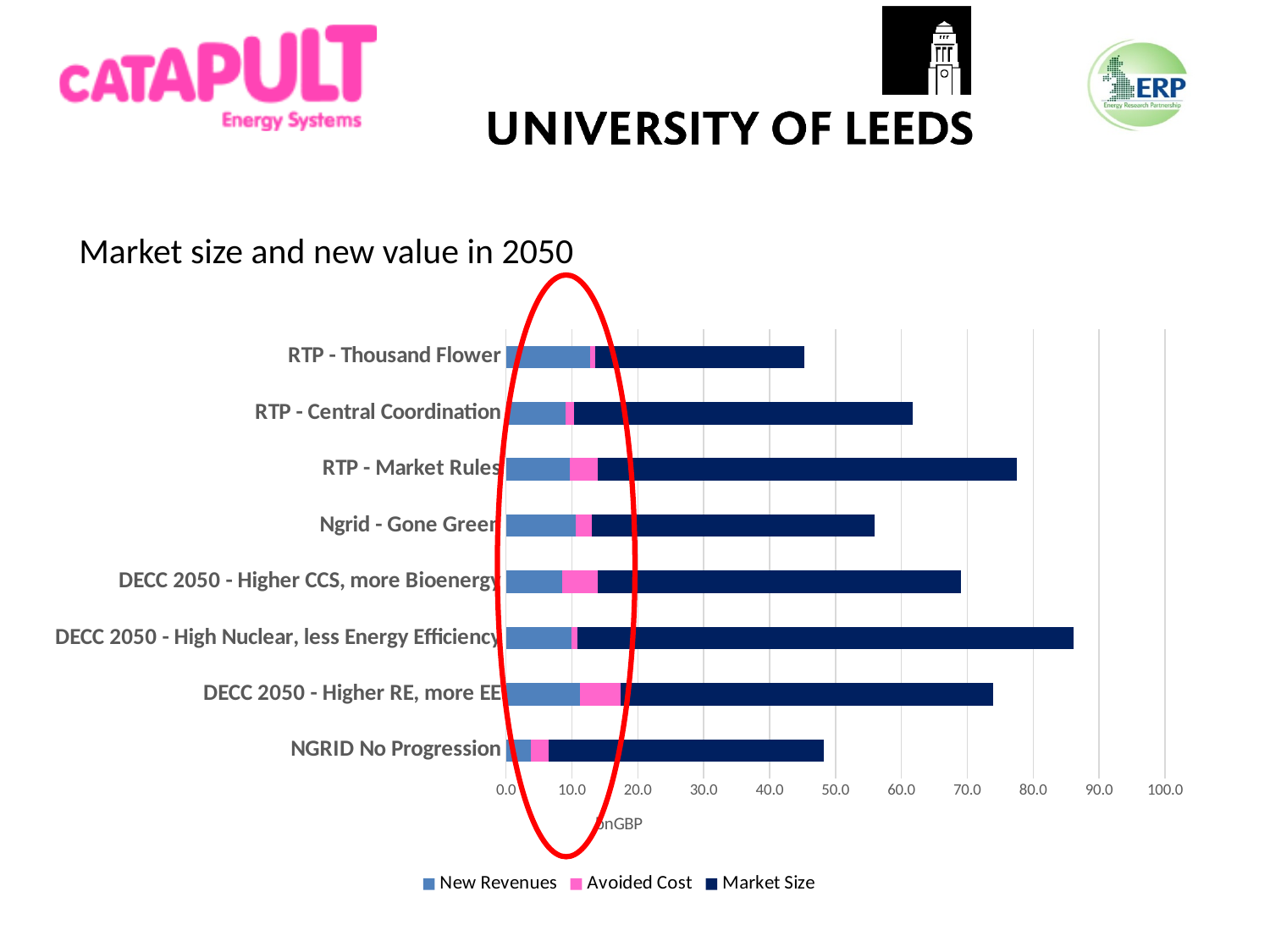
How many series does the chart legend list? 3 Is the total bar for DECC 2050 - High Nuclear, less Energy Efficiency greater or less than 80.0? greater Which scenario has the longest total bar in the chart? DECC 2050 - High Nuclear, less Energy Efficiency What kind of chart is shown on the slide? bar chart Is the total bar for RTP - Market Rules greater or less than 70.0? greater Which series is shown in pink in the chart legend? Avoided Cost Is the total bar for RTP - Central Coordination greater or less than 70.0? less What is the title shown above the chart? Market size and new value in 2050 Which has the longer total bar: RTP - Market Rules or Ngrid - Gone Green? RTP - Market Rules How many scenarios (categories) are plotted in the chart? 8